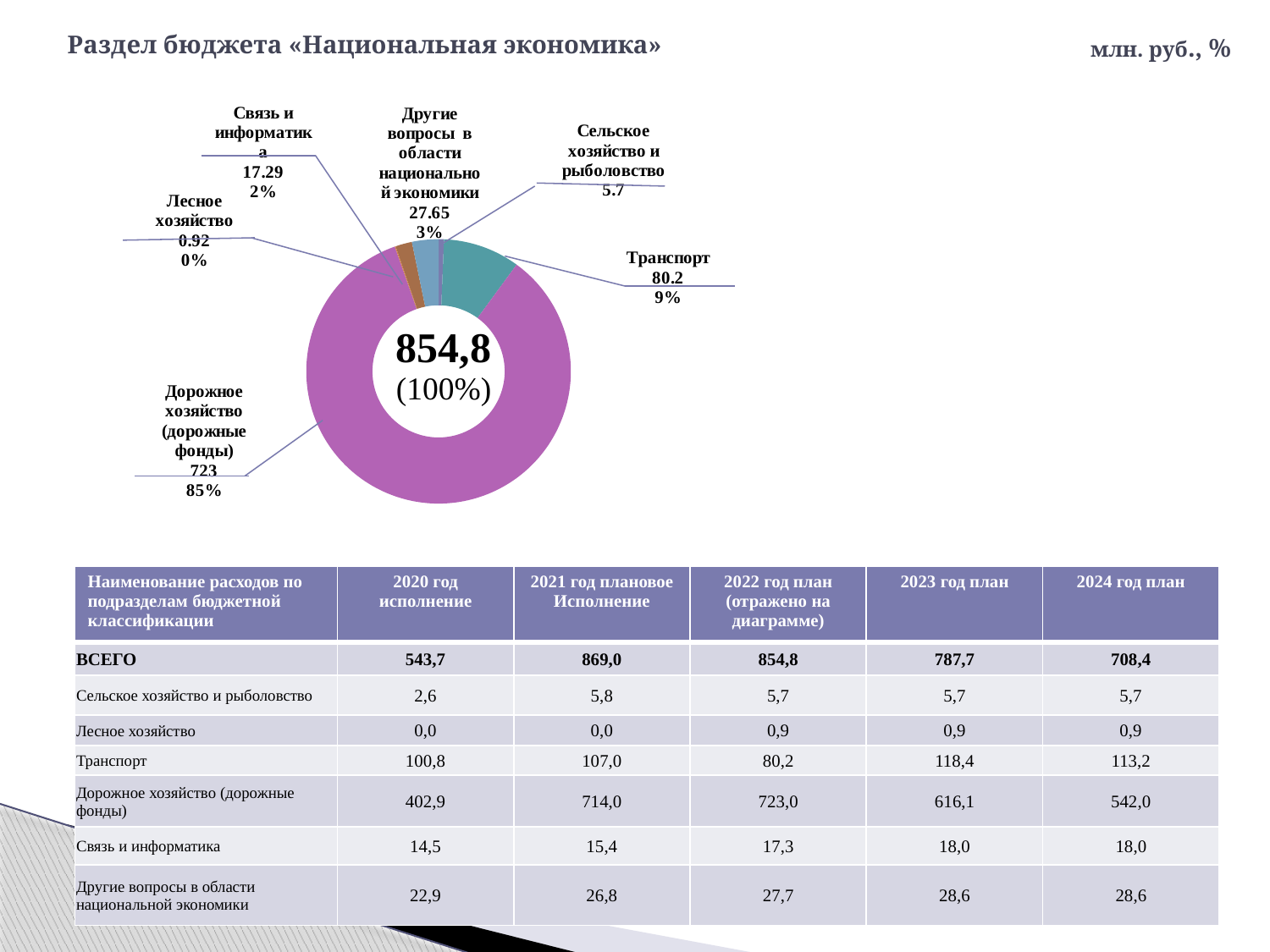
What is the value shown for Лесное хозяйство on the chart? 0.92 What percentage share does Транспорт have on the chart? 9% Which category has the largest slice on the chart? Дорожное хозяйство (дорожные фонды) What is the value shown for Связь и информатика on the chart? 17.29 What is the value shown for Транспорт on the chart? 80.2 What percentage share does Дорожное хозяйство (дорожные фонды) have on the chart? 85% Which category has the smallest slice on the chart? Лесное хозяйство What total value is shown in the centre of the doughnut chart? 854,8 How many categories are shown on the chart? 6 What kind of chart is shown on the slide? doughnut (pie) chart What is the value shown for Сельское хозяйство и рыболовство on the chart? 5.7 Which is larger on the chart: Транспорт or Другие вопросы в области национальной экономики? Транспорт